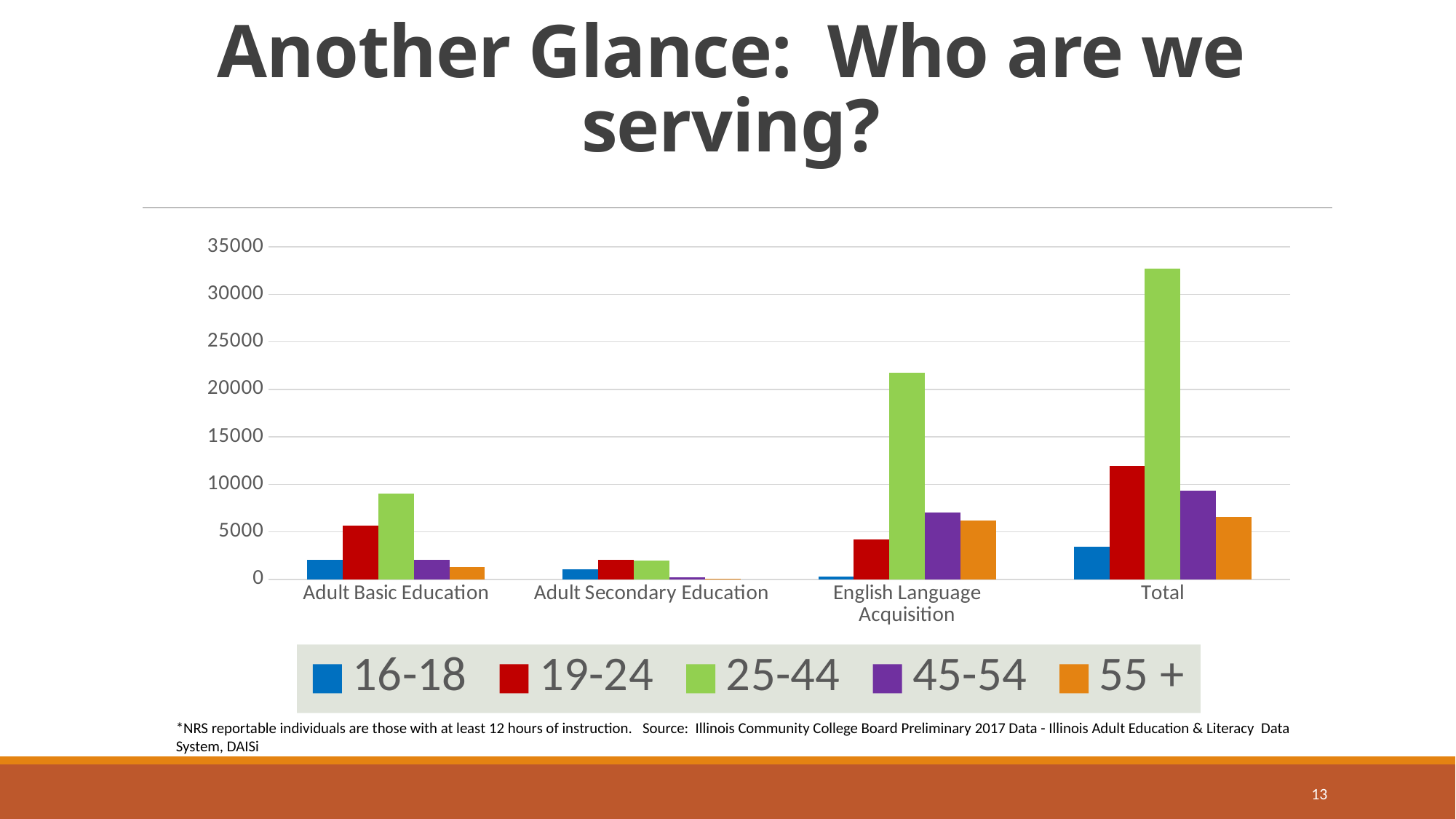
What kind of chart is shown on the slide? bar chart Is the value for 25-44 in Adult Basic Education greater or less than 10000? less What colour represents the 25-44 age group in the legend? green How many age-group series does the legend list? 5 Is the value for 25-44 in the Total category greater or less than 30000? greater In English Language Acquisition, which is larger, the 45-54 bar or the 16-18 bar? 45-54 Which age group has the tallest bar in the Total category? 25-44 Is the value for 25-44 in English Language Acquisition greater or less than 20000? greater How many program categories are shown on the x axis? 4 In Adult Basic Education, which is larger, the 19-24 bar or the 45-54 bar? 19-24 Which program category has the lowest bar for the 25-44 age group? Adult Secondary Education